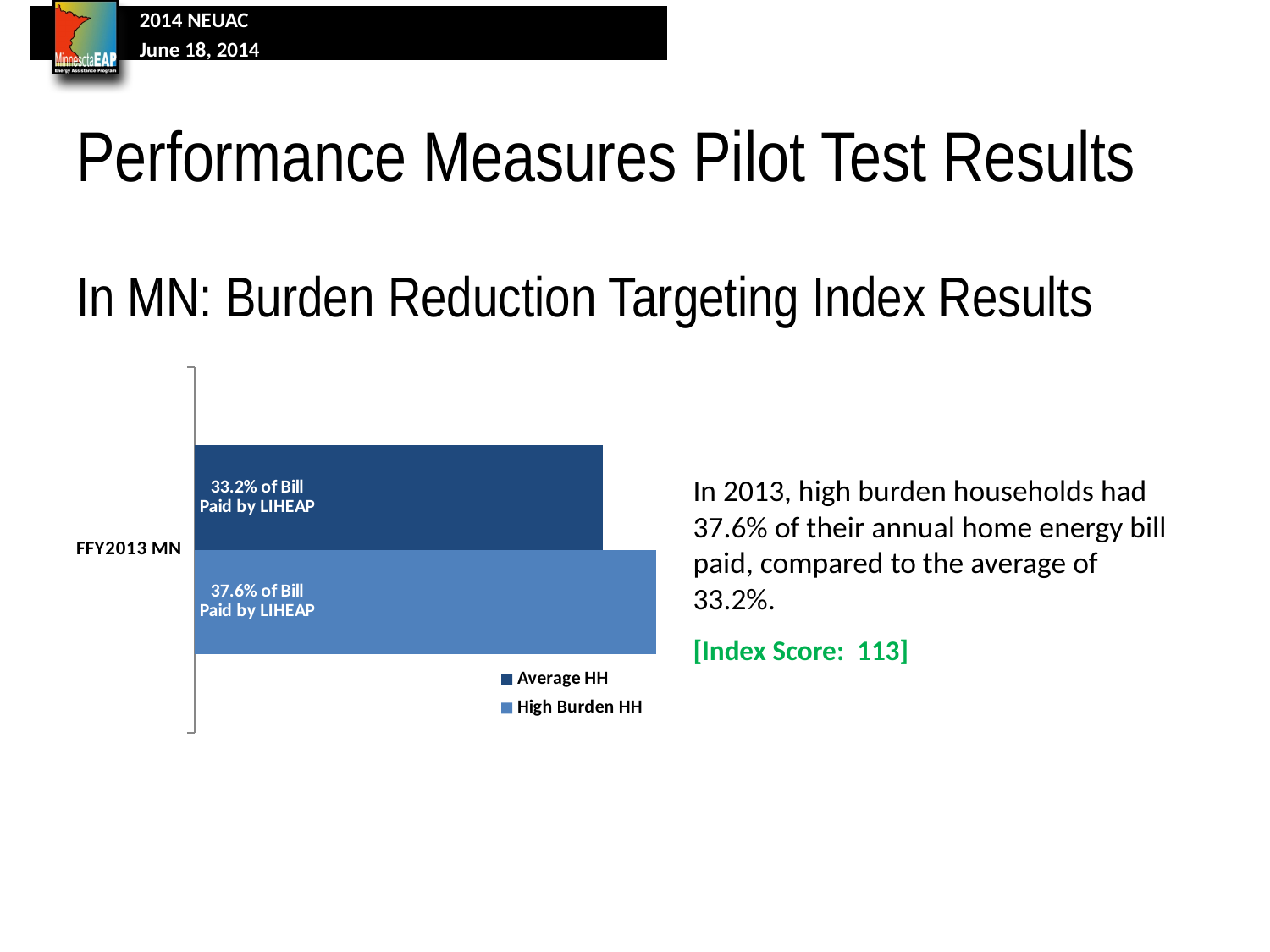
Which series has the lowest value in the chart? Average HH What percentage of the bill was paid by LIHEAP for High Burden HH in FFY2013 MN? 37.6% What is the category label shown on the chart's axis? FFY2013 MN Which series has the larger value in the chart, Average HH or High Burden HH? High Burden HH What kind of chart is shown on the slide? bar chart Which series is shown in the darker blue colour in the chart? Average HH What percentage of the bill was paid by LIHEAP for Average HH in FFY2013 MN? 33.2% What is the difference in percentage points between the High Burden HH and Average HH values? 4.4 Which series has the highest value in the chart? High Burden HH How many categories are shown on the chart's category axis? 1 How many series does the chart legend list? 2